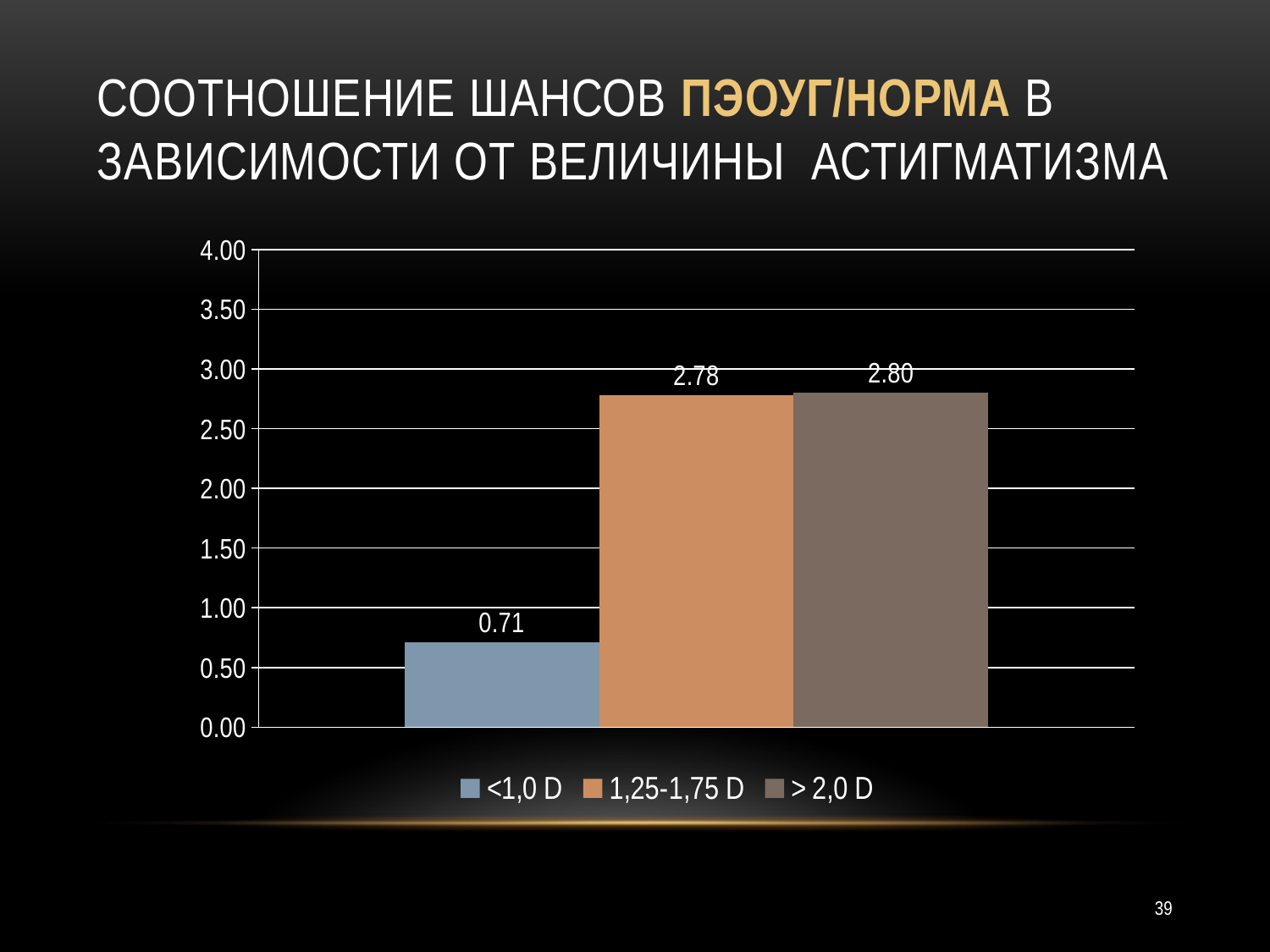
Which category has the highest value? > 2,0 D What is the value for the > 2,0 D bar? 2.80 Which is larger, the value for 1,25-1,75 D or the value for <1,0 D? 1,25-1,75 D What is the difference between the values for > 2,0 D and <1,0 D? 2.09 Is the value for <1,0 D greater or less than 1.00? less What is the value for the 1,25-1,75 D bar? 2.78 What is the value for the <1,0 D bar? 0.71 What is the difference between the values for 1,25-1,75 D and <1,0 D? 2.07 Which category has the lowest value? <1,0 D How many bars are plotted on the chart? 3 How many entries does the legend list? 3 What kind of chart is shown on the slide? bar chart